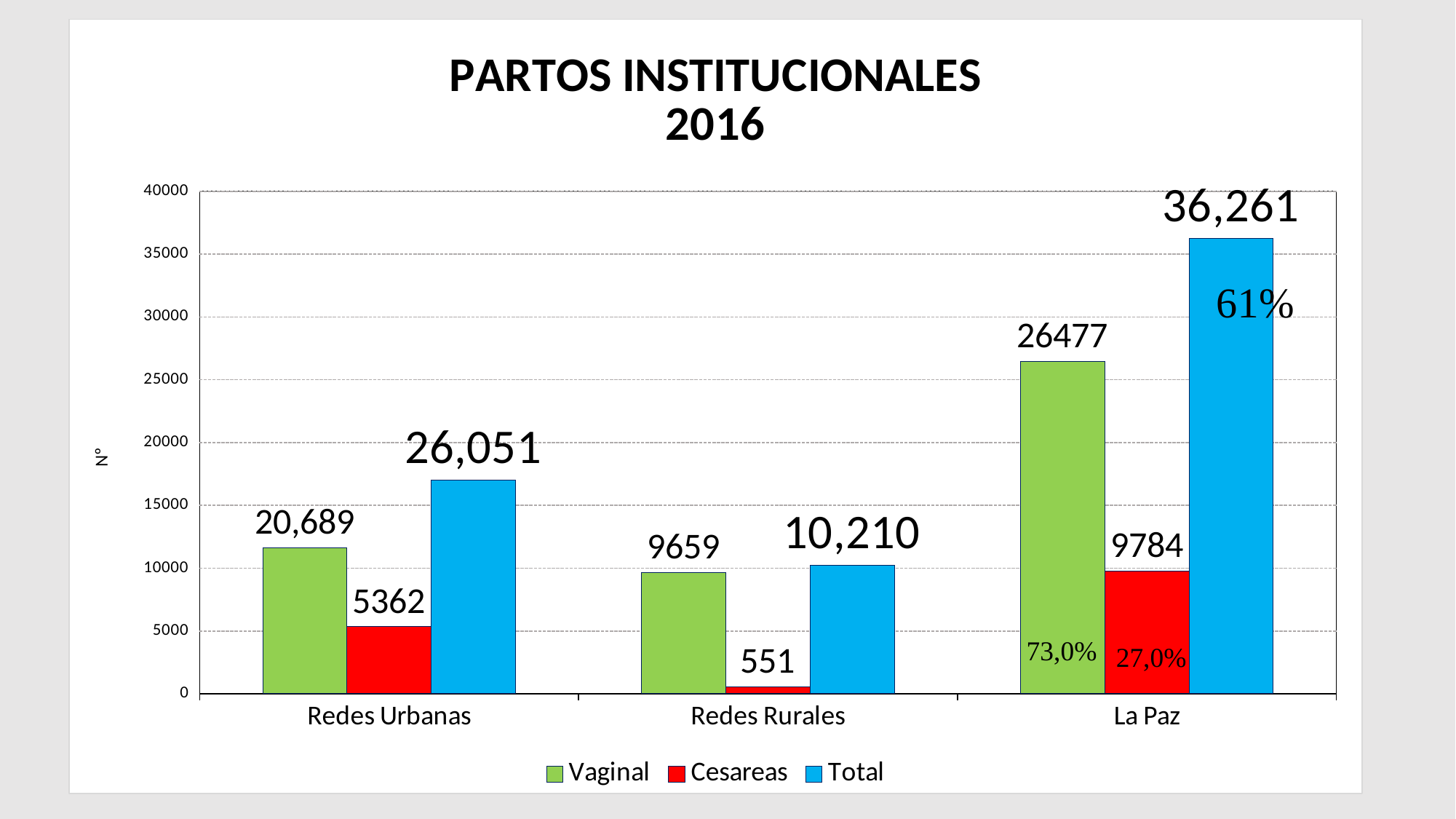
What is the Cesareas value for Redes Rurales? 551 How many categories are shown on the x axis? 3 Which category has the highest Total value? La Paz What is the Total value for Redes Rurales? 10,210 What is the difference between the Vaginal and Cesareas values for La Paz? 16693 How many series does the legend list? 3 Which is larger, the Vaginal value for Redes Urbanas or the Vaginal value for Redes Rurales? Redes Urbanas What is the Vaginal value for Redes Urbanas? 20,689 What is the Total value for La Paz? 36,261 What is the title of the chart? PARTOS INSTITUCIONALES 2016 What type of chart is shown on the slide? bar chart Which category has the lowest Cesareas value? Redes Rurales